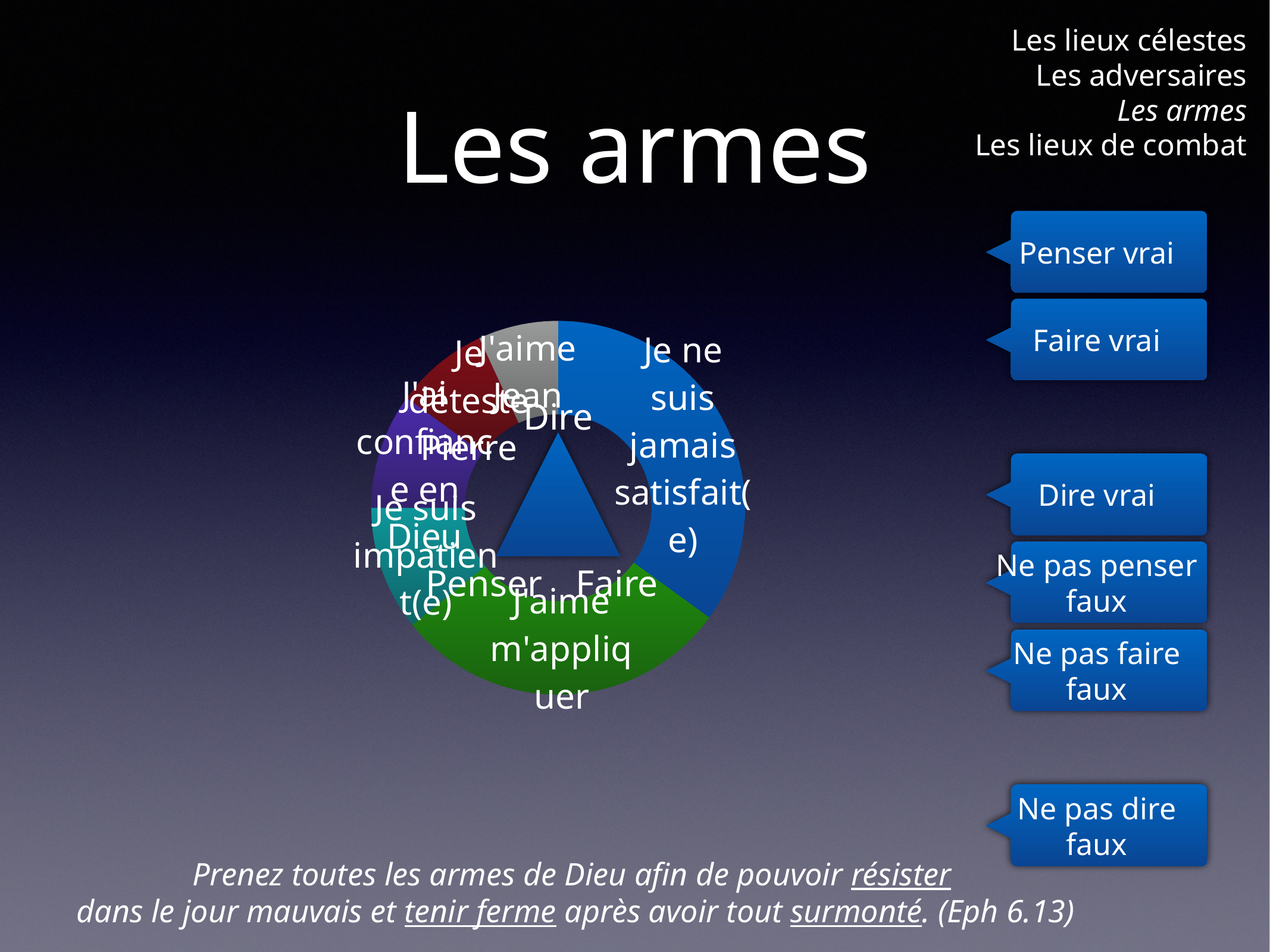
What kind of chart is shown on the slide? doughnut chart What colour is the "J'aime m'appliquer" slice? green Which slice of the doughnut chart is the largest? Je ne suis jamais satisfait(e) Which slice is larger, "Je ne suis jamais satisfait(e)" or "J'aime m'appliquer"? Je ne suis jamais satisfait(e) How many slices does the doughnut chart have? 6 What colour is the largest slice of the doughnut chart? blue Which slice is larger, "J'aime m'appliquer" or "Je suis impatient(e)"? J'aime m'appliquer